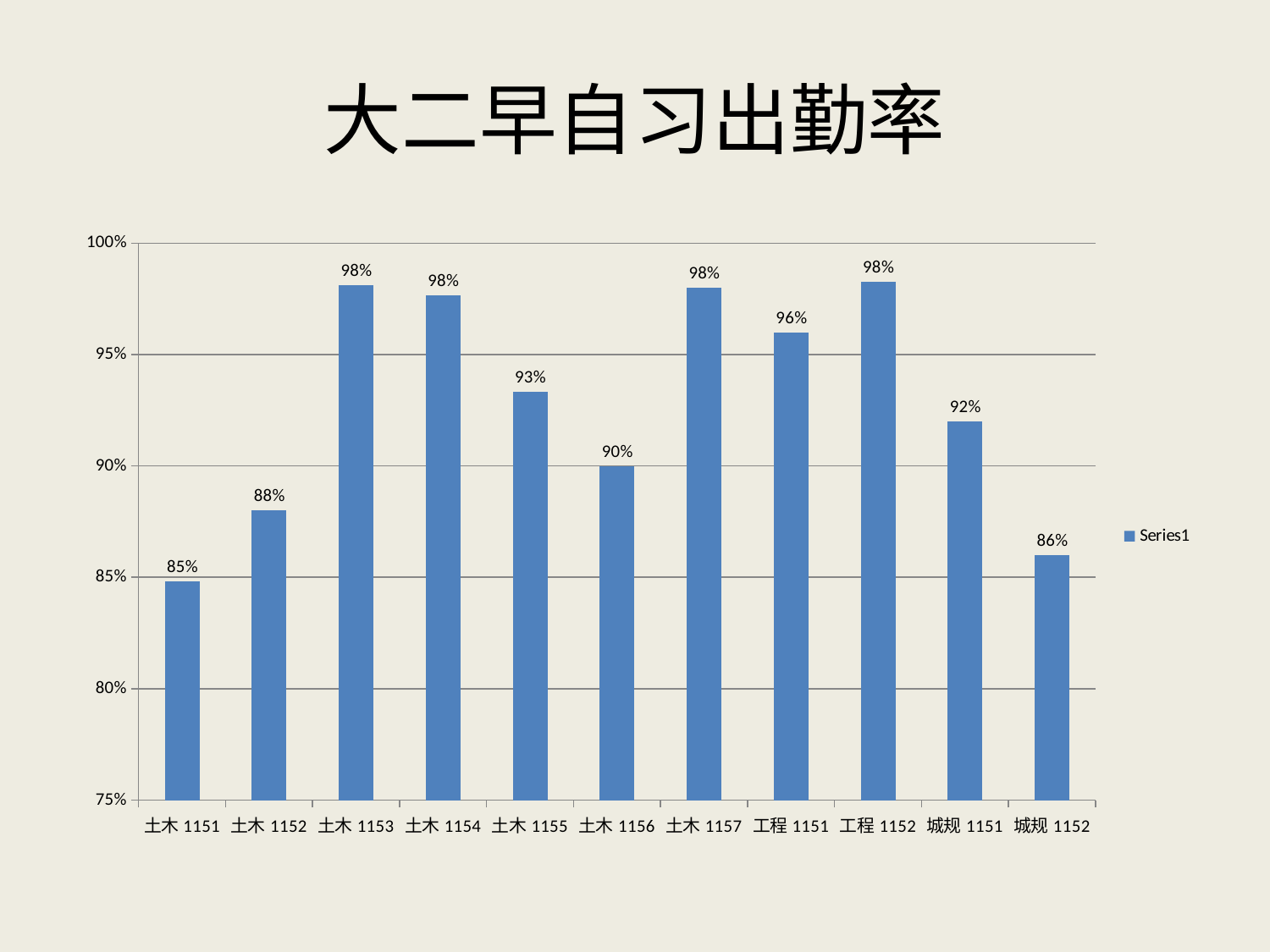
What kind of chart is shown on the slide? bar chart What is the title of the chart? 大二早自习出勤率 Which category has the lowest value? 土木 1151 Is the value for 土木 1152 greater or less than 90%? less What is the value for 土木 1155? 93% What is the value for 工程 1151? 96% How many categories are shown on the x axis? 11 What is the difference between the values for 工程 1151 and 城规 1152? 10% What is the difference between the values for 土木 1153 and 土木 1151? 13% What is the value for 城规 1152? 86% Which is larger, the value for 土木 1156 or the value for 城规 1151? 城规 1151 What is the value for 土木 1151? 85%